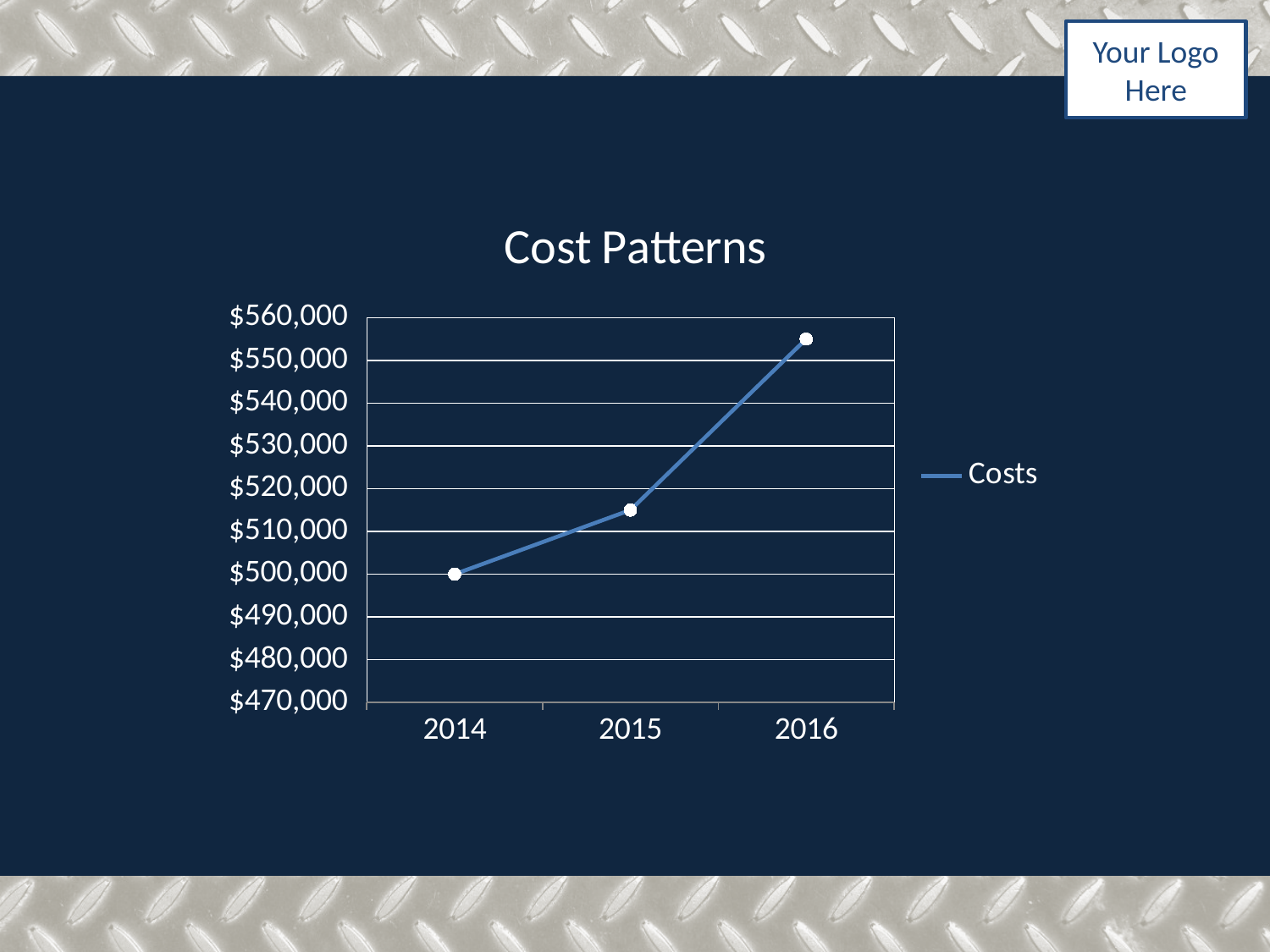
Is the value for Costs in 2016 greater or less than $550,000? greater What is the value for Costs in 2014? $500,000 What is the name of the series shown in the legend? Costs Is the value for Costs in 2015 greater or less than $520,000? less What kind of chart is shown on the slide? line chart Which year has the lowest Costs value? 2014 How many years are plotted on the x axis? 3 Do the Costs values rise or fall from 2014 to 2016? rise Is the value for Costs in 2015 greater or less than $510,000? greater Which year has the highest Costs value? 2016 How many series does the legend list? 1 What is the title of the chart? Cost Patterns